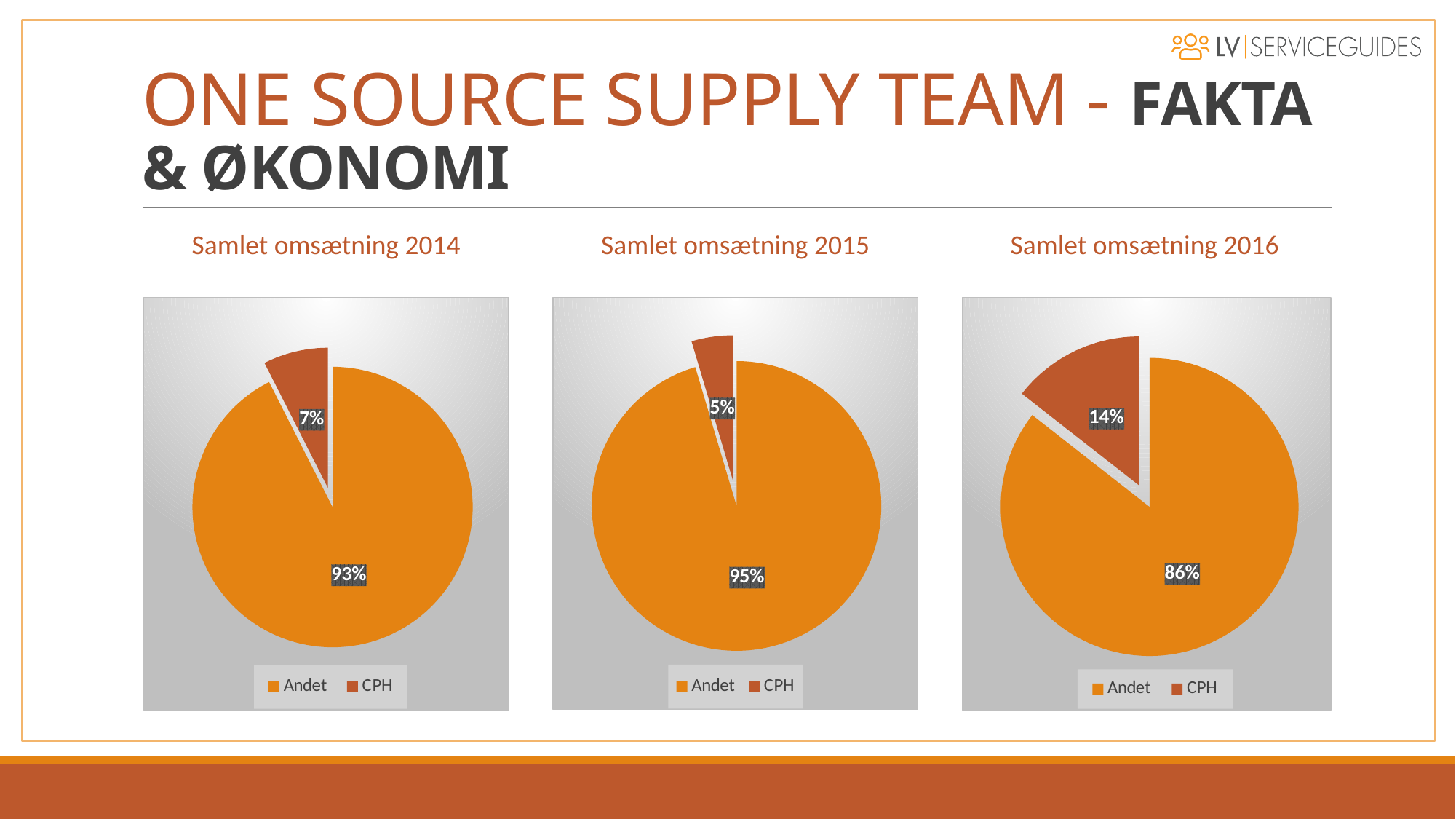
In the 'Samlet omsætning 2015' chart, what share does CPH have? 5% In the 'Samlet omsætning 2016' chart, what share does CPH have? 14% How many entries does the legend of the 'Samlet omsætning 2015' chart list? 2 In the 'Samlet omsætning 2016' chart, what share does Andet have? 86% How many slices does the 'Samlet omsætning 2014' pie chart have? 2 What kind of chart is 'Samlet omsætning 2014'? Pie chart In the 'Samlet omsætning 2015' chart, which slice is the smallest? CPH In the 'Samlet omsætning 2016' chart, what is the difference between the Andet and CPH shares? 72% In the 'Samlet omsætning 2016' chart, which slice is the largest? Andet